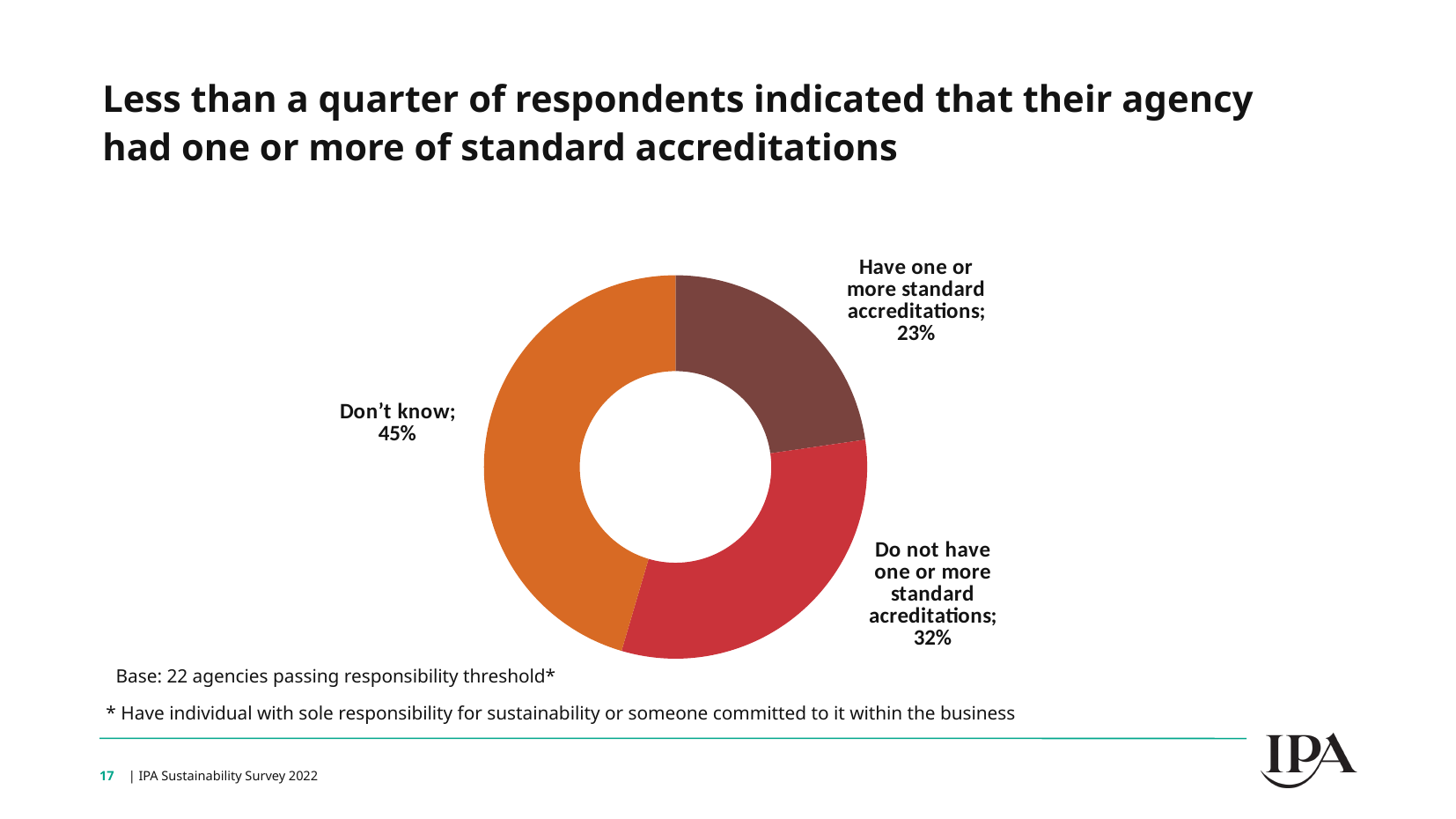
What kind of chart is shown on the slide? Doughnut (pie) chart What percentage of respondents answered 'Don't know'? 45% What is the difference in percentage points between 'Don't know' and 'Have one or more standard accreditations'? 22 Which is larger: the share for 'Do not have one or more standard accreditations' or the share for 'Have one or more standard accreditations'? Do not have one or more standard accreditations What percentage of respondents said their agency has one or more standard accreditations? 23% What percentage of respondents said their agency does not have one or more standard accreditations? 32% How many categories are shown in the chart? 3 What colour is the 'Don't know' segment of the chart? Orange Which response has the smallest share of the chart? Have one or more standard accreditations What is the combined share of respondents who answered 'Have' or 'Do not have' one or more standard accreditations? 55% What is the difference in percentage points between 'Do not have one or more standard accreditations' and 'Have one or more standard accreditations'? 9 Which response has the largest share of the chart? Don't know